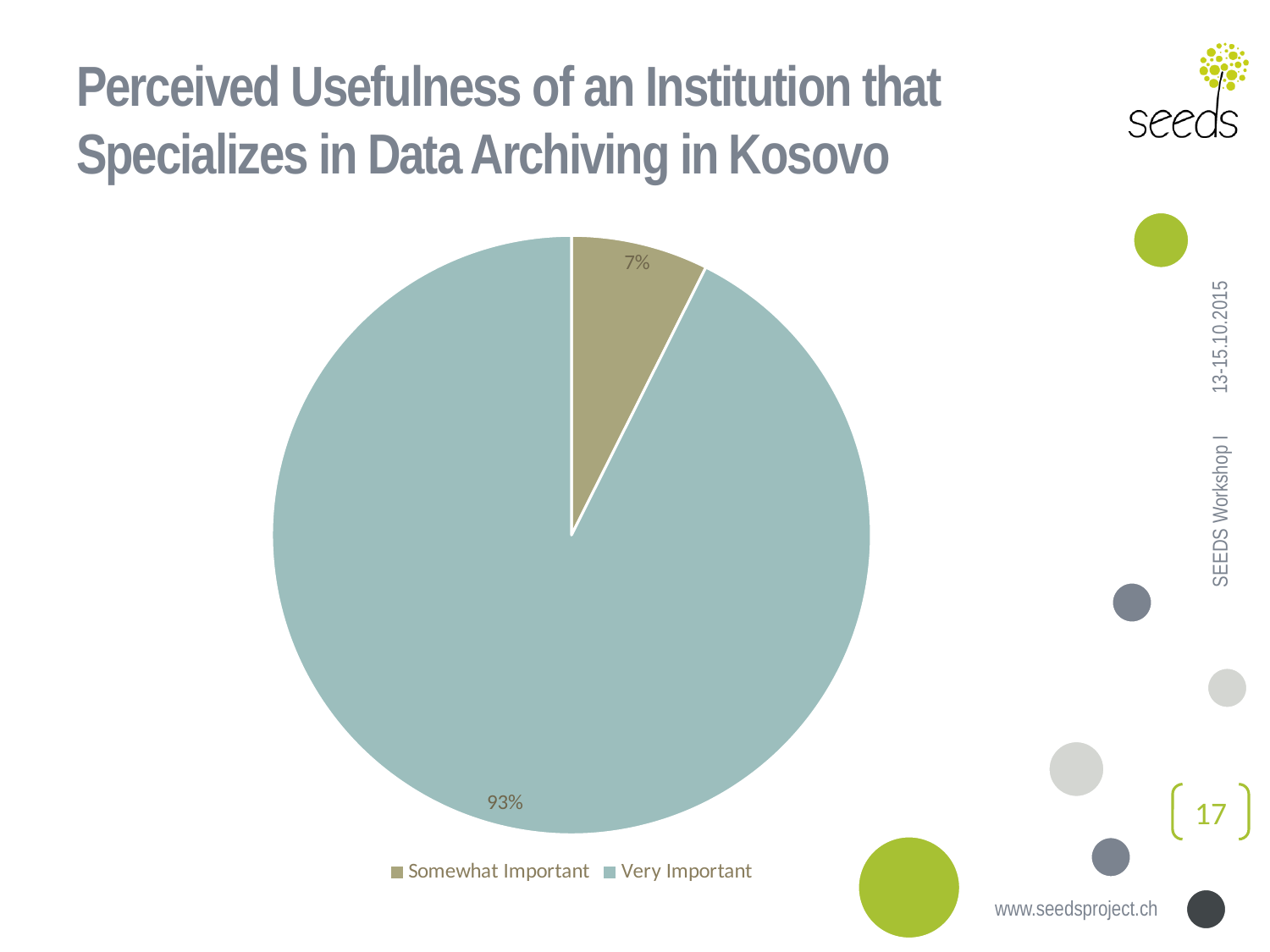
Which category has the largest slice of the pie? Very Important What is the title of the slide containing the chart? Perceived Usefulness of an Institution that Specializes in Data Archiving in Kosovo Which legend entry is shown in the tan/brown colour? Somewhat Important How many entries does the legend list? 2 Which category has the smallest slice of the pie? Somewhat Important What share of the pie is labelled "Very Important"? 93% Which slice is larger, "Somewhat Important" or "Very Important"? Very Important How many categories does the pie chart show? 2 What share of the pie is labelled "Somewhat Important"? 7% What kind of chart is shown on the slide? pie chart What is the difference in percentage points between the "Very Important" and "Somewhat Important" slices? 86